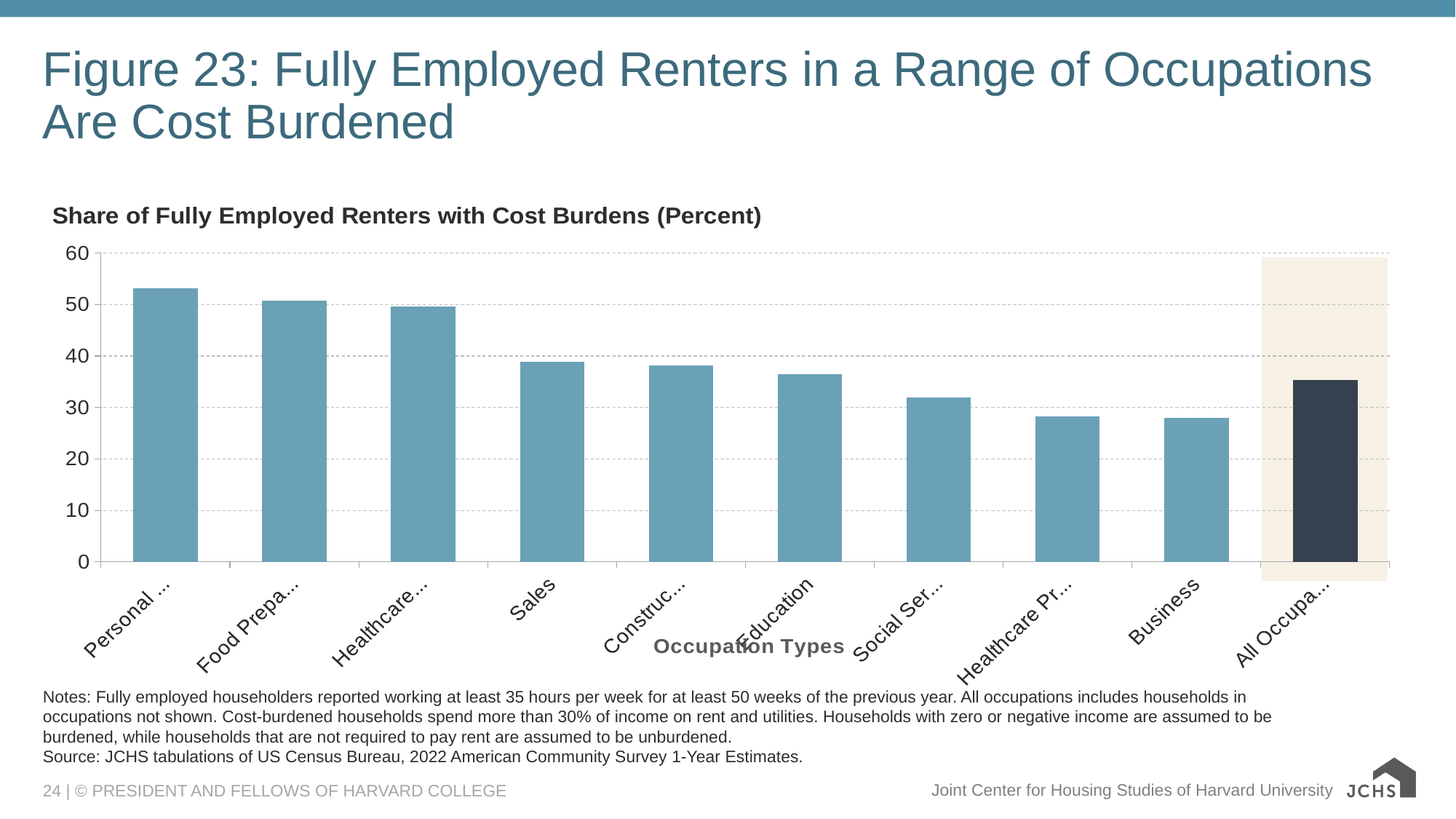
Do the values of the light blue occupation bars rise or fall from left to right across the x axis? fall Is the value for Education greater or less than 40? less Is the value for Sales greater or less than 30? greater How many bars (occupation categories) are plotted in the chart? 10 Which has a higher share of cost-burdened fully employed renters, Sales or Education? Sales What kind of chart is shown on the slide? bar chart Is the value for Business greater or less than 30? less What is the x-axis title of the chart? Occupation Types What is the title of the chart? Share of Fully Employed Renters with Cost Burdens (Percent) Which has a higher share of cost-burdened fully employed renters, Education or Business? Education